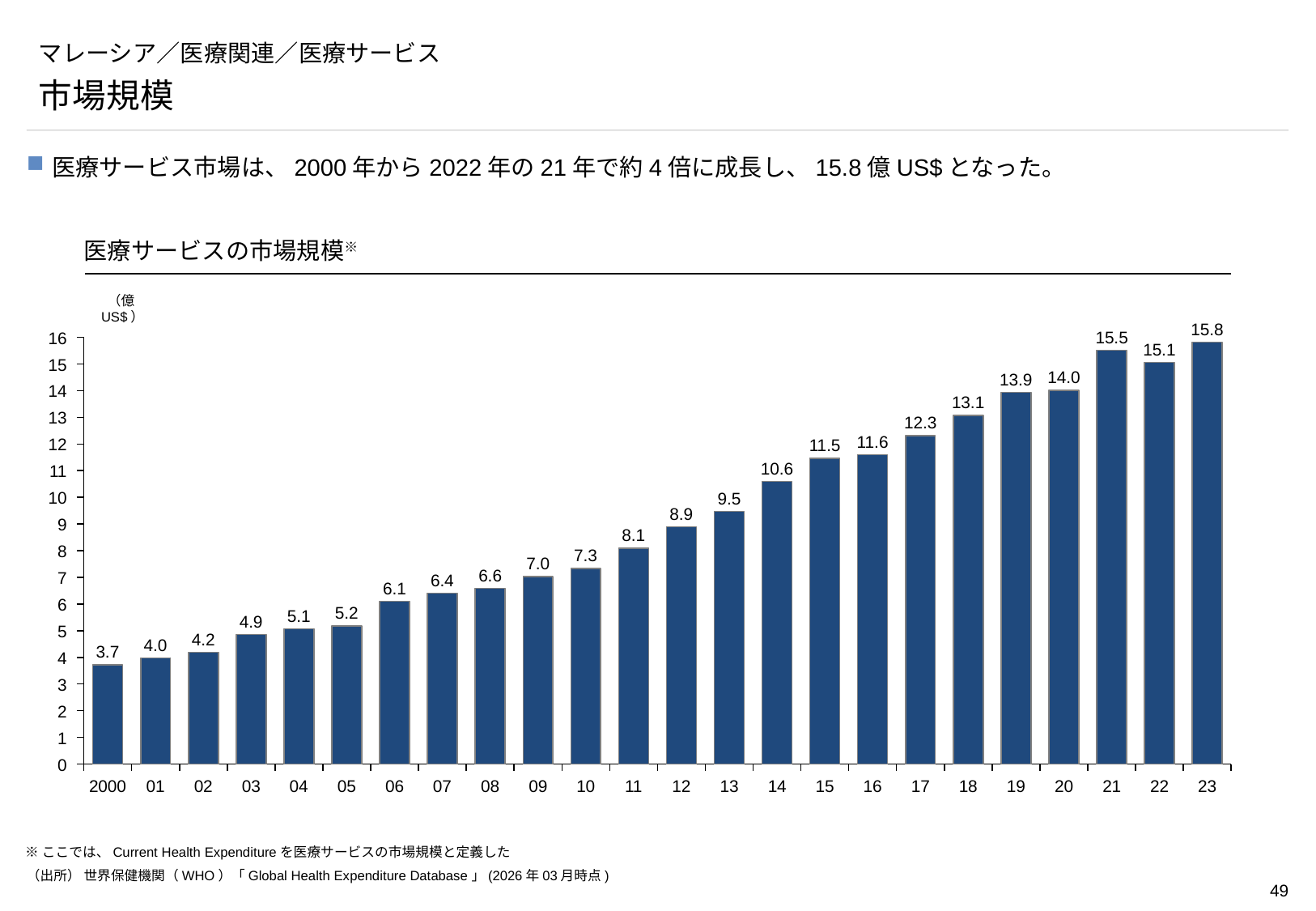
Which year has the highest value in the chart? 23 What is the value for 23 (2023) in the chart? 15.8 How many bars (years) are shown in the chart? 24 What is the difference between the values for 23 and 2000? 12.1 What unit is shown on the vertical axis of the chart? 億US$ What is the difference between the values for 21 and 22? 0.4 What is the value for 14 (2014) in the chart? 10.6 What kind of chart is shown on the slide? bar chart Which is larger, the value for 21 or the value for 22? 21 What is the value for 2000 in the 医療サービスの市場規模 chart? 3.7 Is the value for 13 greater or less than 10? less Which year has the lowest value in the chart? 2000